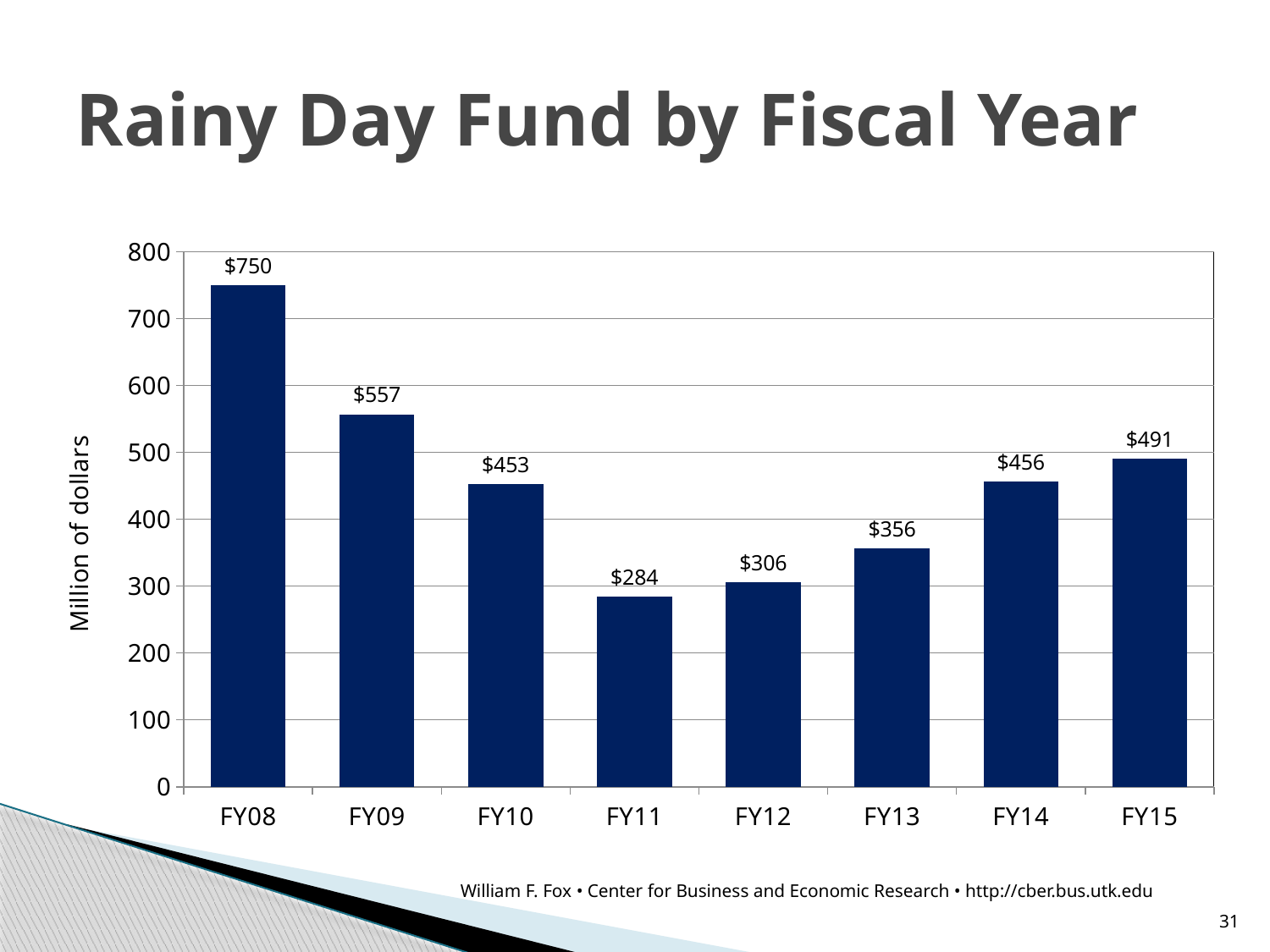
What is the Rainy Day Fund value for FY11? $284 Which is larger, the value for FY10 or the value for FY14? FY14 What kind of chart is shown on the slide? bar chart Which fiscal year has the lowest Rainy Day Fund value? FY11 What is the Rainy Day Fund value for FY15? $491 What is the difference between the FY15 and FY14 values? $35 Is the value for FY13 greater or less than 400? less What is the label on the vertical axis of the chart? Million of dollars What is the Rainy Day Fund value for FY08? $750 How many fiscal years are shown on the chart? 8 Which fiscal year has the highest Rainy Day Fund value? FY08 What is the difference between the FY08 and FY09 values? $193